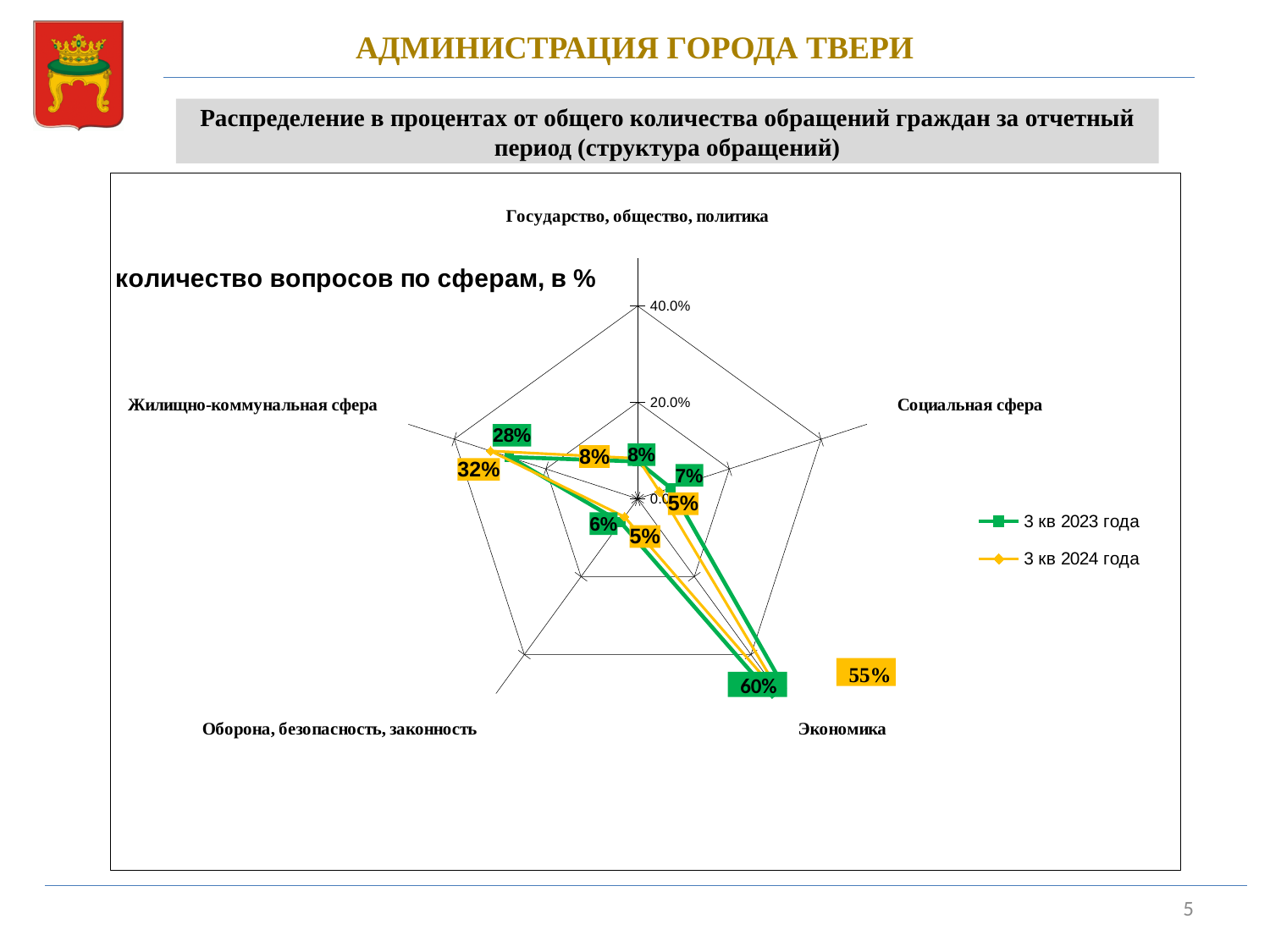
What is the value for Экономика in the 3 кв 2023 года series? 60% How many series does the legend list? 2 What kind of chart is shown on the slide? radar chart What is the difference between the 3 кв 2024 года and 3 кв 2023 года values for Жилищно-коммунальная сфера? 4% What is the value for Экономика in the 3 кв 2024 года series? 55% Which category has the highest value in the 3 кв 2023 года series? Экономика Which is larger for Жилищно-коммунальная сфера: the 3 кв 2023 года value or the 3 кв 2024 года value? 3 кв 2024 года What is the title of the chart? количество вопросов по сферам, в % What is the difference between the 3 кв 2023 года and 3 кв 2024 года values for Экономика? 5% What is the value for Социальная сфера in the 3 кв 2023 года series? 7% What is the value for Жилищно-коммунальная сфера in the 3 кв 2024 года series? 32% How many categories (axes) does the radar chart have? 5